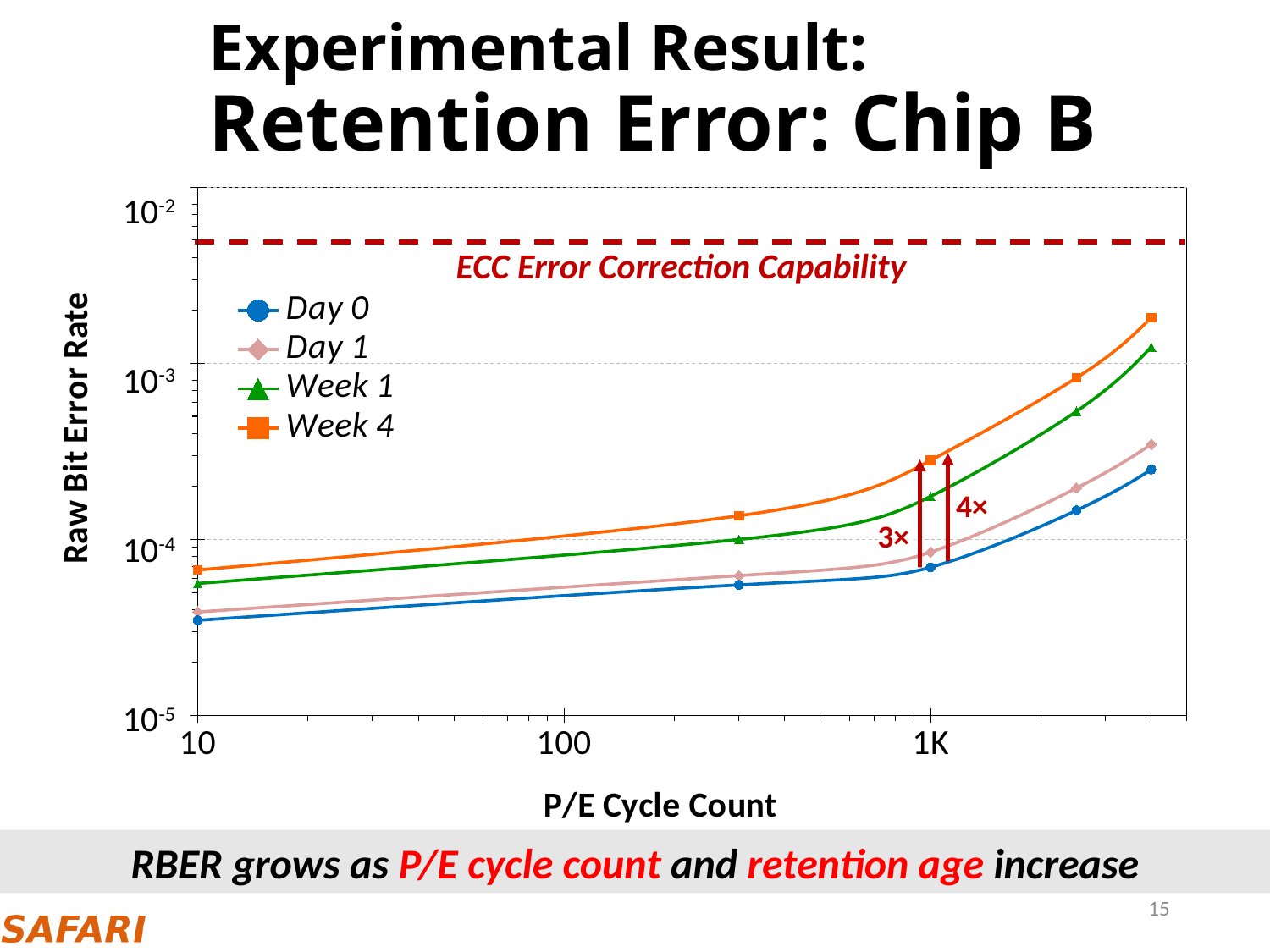
How many data points are plotted for the Day 0 series? 5 Is the highest plotted Raw Bit Error Rate for Week 4 greater or less than 10^-3? greater What kind of chart is shown on the slide? line chart At 1K P/E cycles, which is larger: the Raw Bit Error Rate for Week 4 or for Day 0? Week 4 Which series has the lowest Raw Bit Error Rate across all P/E cycle counts? Day 0 What does the red dashed horizontal line represent? ECC Error Correction Capability Is the Raw Bit Error Rate for Week 4 at 10 P/E cycles greater or less than 10^-4? less What is the label of the x axis? P/E Cycle Count Does the Raw Bit Error Rate rise or fall as the P/E Cycle Count increases? rise Is the Raw Bit Error Rate for Week 1 at 1K P/E cycles greater or less than 10^-4? greater Which series has the highest Raw Bit Error Rate across all P/E cycle counts? Week 4 How many series does the legend list? 4